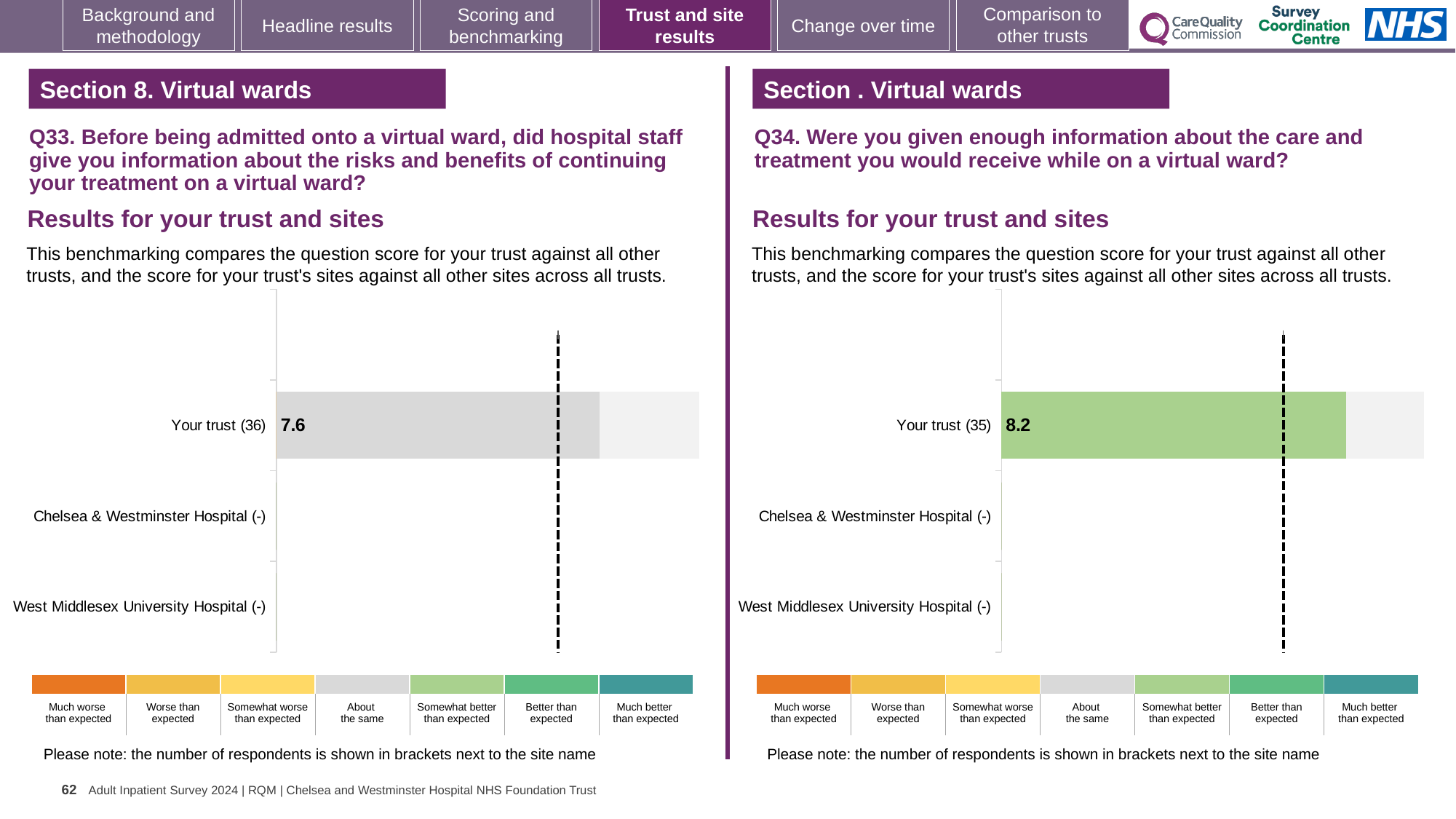
What kind of chart is used on the left (Q33)? Bar chart Which is larger: the Your trust score on the left chart (Q33) or the Your trust score on the right chart (Q34)? Right chart (Q34), 8.2 How many categories are listed on the right chart (Q34)? 3 On the right chart (Q34), how many respondents are shown in brackets next to Your trust? 35 On the right chart (Q34), which benchmark category does the colour of the Your trust bar correspond to? Somewhat better than expected On the left chart (Q33), how many respondents are shown in brackets next to Your trust? 36 How many benchmark categories does the colour key below the left chart (Q33) list? 7 How many categories are listed on the left chart (Q33)? 3 On the right chart (Q34), what is the score for Your trust? 8.2 On the left chart (Q33), which category has the highest score shown? Your trust (36) What is the difference between the Your trust score on the right chart (Q34) and the Your trust score on the left chart (Q33)? 0.6 On the left chart (Q33), what is the score for Your trust? 7.6